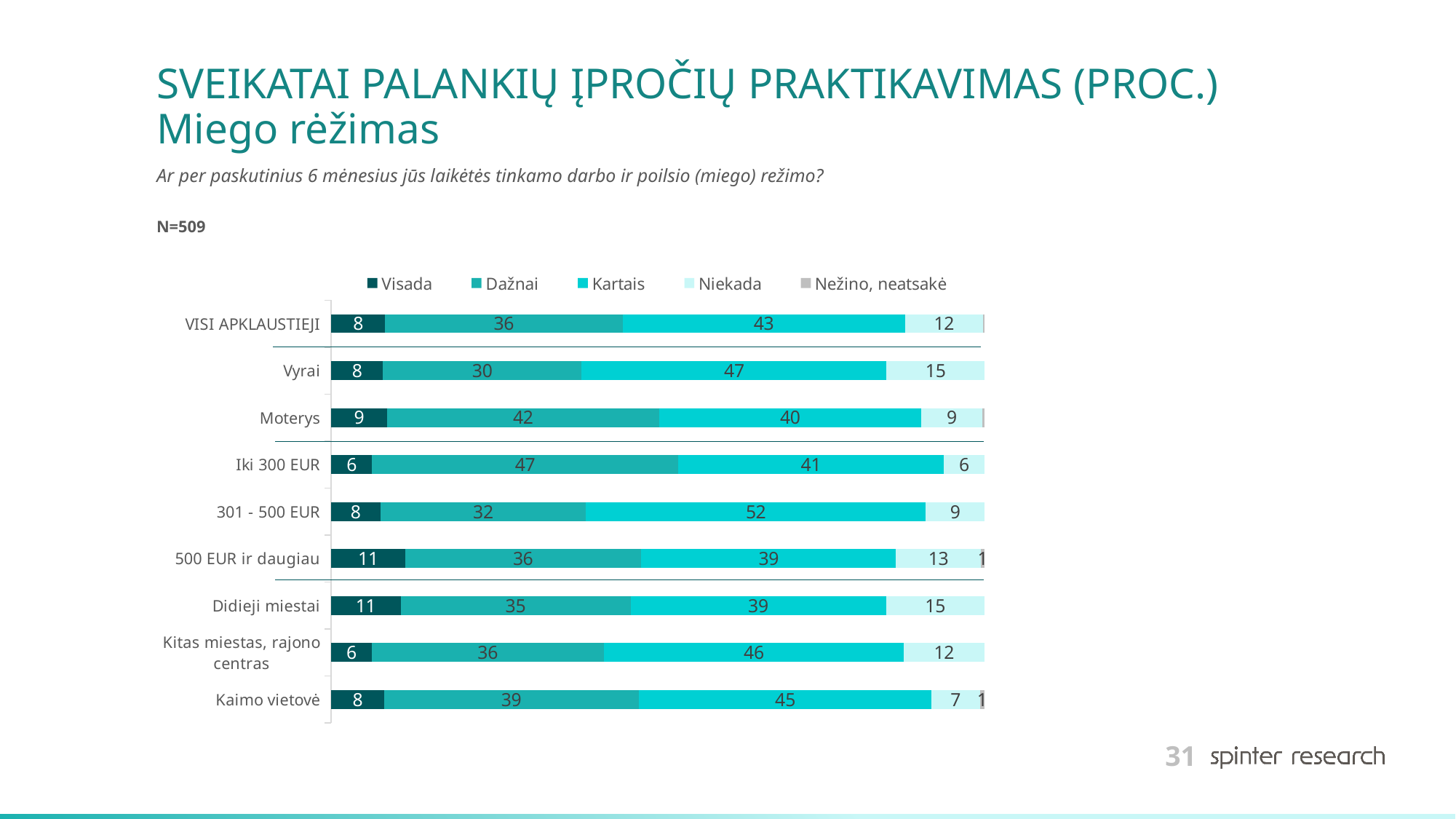
What is the total of the stacked bar for 'Vyrai'? 100 Which is larger: the 'Dažnai' value for 'Iki 300 EUR' or for '301 - 500 EUR'? Iki 300 EUR Which category has the highest value for 'Kartais'? 301 - 500 EUR How many categories (groups) are plotted on the chart? 9 What is the value of 'Niekada' for 'Didieji miestai'? 15 What is the sample size (N) stated on the slide? N=509 What is the difference between the 'Kartais' values for 'Vyrai' and 'Moterys'? 7 What is the value of 'Dažnai' for 'Moterys'? 42 Which category has the lowest value for 'Dažnai'? Vyrai What is the value of 'Kartais' for 'VISI APKLAUSTIEJI'? 43 What kind of chart is shown on the slide? stacked bar chart How many series does the legend list? 5